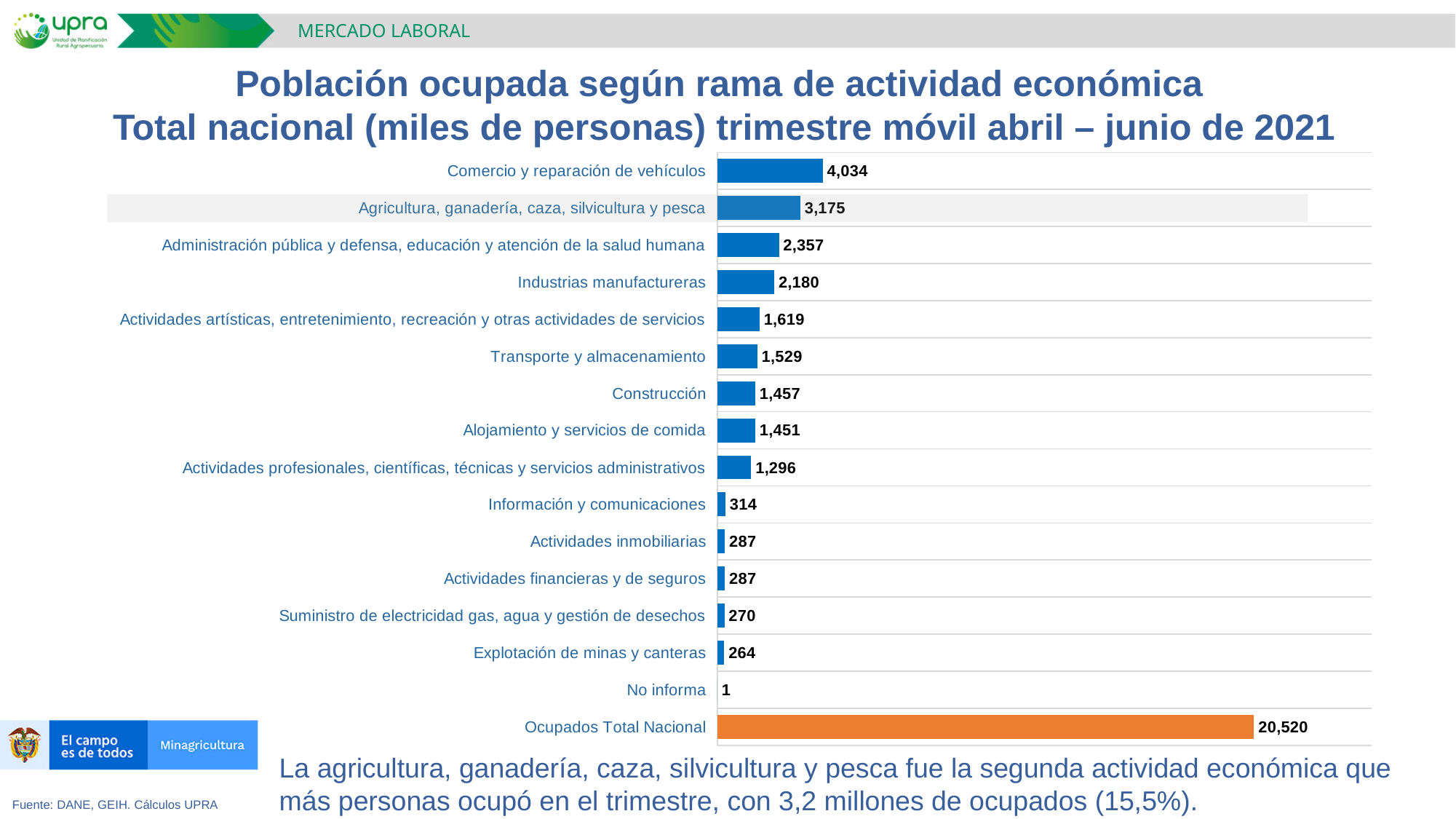
What is the value for Explotación de minas y canteras? 264 Which category has the lowest value? No informa What is the value for Industrias manufactureras? 2,180 What is the value for Comercio y reparación de vehículos? 4,034 What is the value for Agricultura, ganadería, caza, silvicultura y pesca? 3,175 What is the value for Ocupados Total Nacional? 20,520 How many bars are shown in the chart? 16 Which is larger, Industrias manufactureras or Transporte y almacenamiento? Industrias manufactureras What is the difference between Comercio y reparación de vehículos and Agricultura, ganadería, caza, silvicultura y pesca? 859 What type of chart is shown on the slide? bar chart Excluding Ocupados Total Nacional, which category has the highest value? Comercio y reparación de vehículos Which bar is shown in orange rather than blue? Ocupados Total Nacional